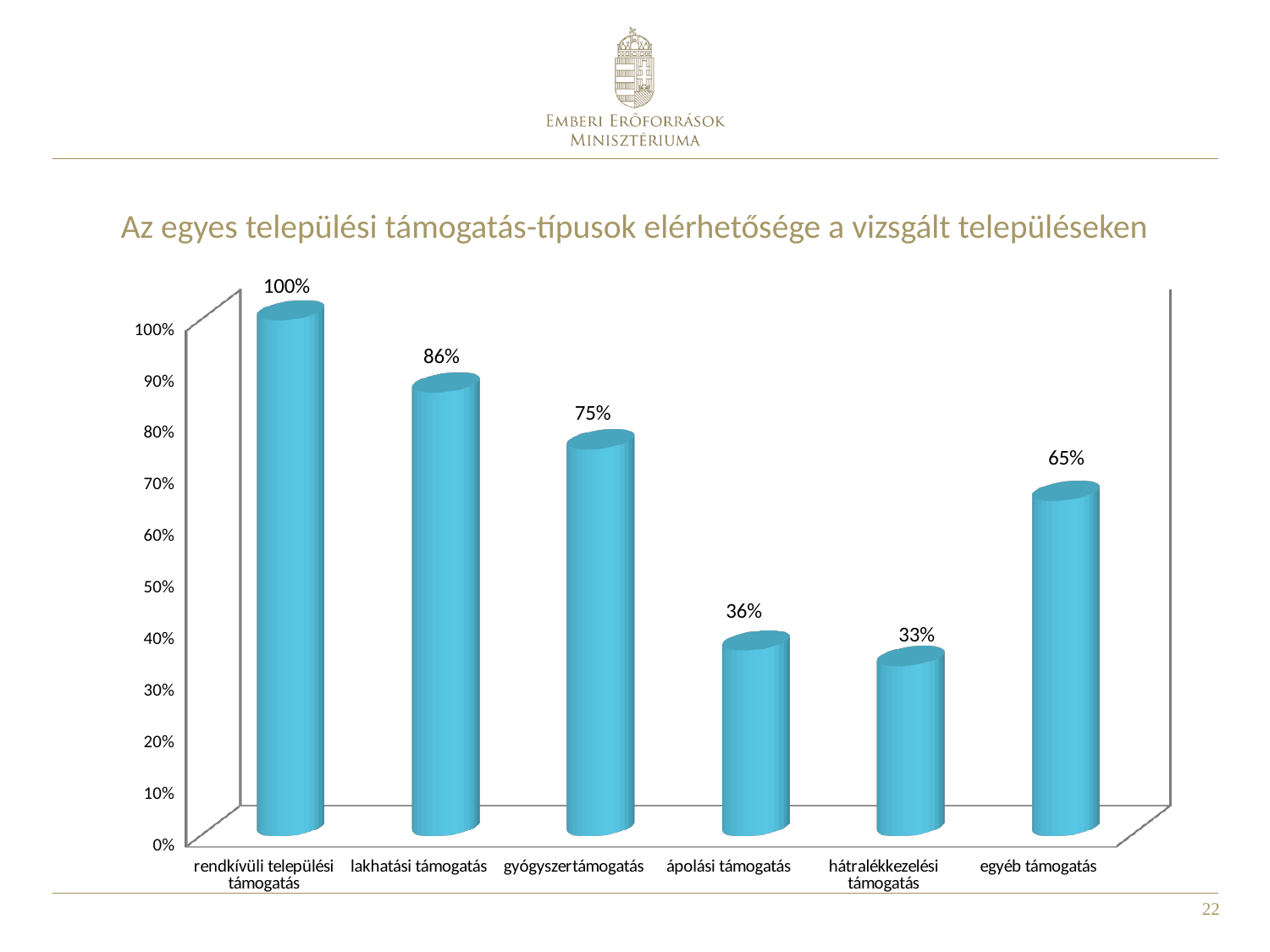
How many categories are shown on the chart? 6 What is the difference between the values for gyógyszertámogatás and hátralékkezelési támogatás? 42% Is the value for gyógyszertámogatás greater or less than 70%? greater Which category has the highest value? rendkívüli települési támogatás What is the difference between the values for rendkívüli települési támogatás and lakhatási támogatás? 14% What is the value for egyéb támogatás? 65% What kind of chart is shown on the slide? bar chart What is the value for lakhatási támogatás? 86% Which is larger, the value for egyéb támogatás or the value for ápolási támogatás? egyéb támogatás What is the title of the chart? Az egyes települési támogatás-típusok elérhetősége a vizsgált településeken Which category has the lowest value? hátralékkezelési támogatás What is the value for ápolási támogatás? 36%